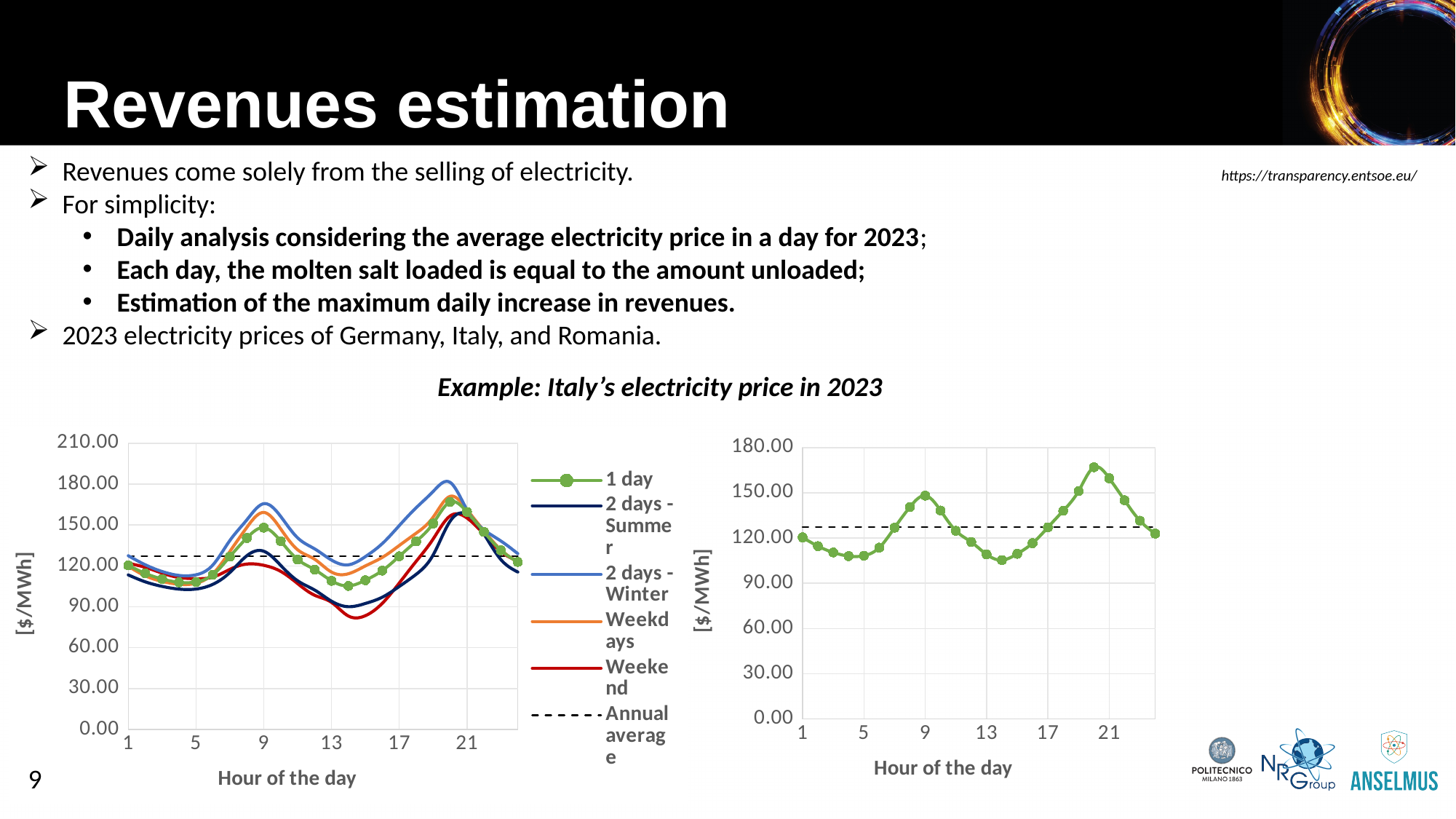
In the left chart, at hour 9, which series has the larger value: 2 days - Winter or Weekend? 2 days - Winter What is the title shown above the two charts? Example: Italy's electricity price in 2023 In the left chart, which series reaches the highest peak value? 2 days - Winter What type of chart is the left chart on the slide? line chart What is the y-axis label of the right chart? [$/MWh] In the left chart, is the value of the Weekend series at hour 14 greater or less than 90.00? less In the right chart, is the value at hour 20 greater or less than 150.00? greater How many series does the legend of the left chart list? 6 In the left chart, is the value of the 2 days - Winter series at hour 9 greater or less than 150.00? greater In the right chart, do the values rise or fall from hour 5 to hour 9? rise In the left chart, which series drops to the lowest value? Weekend